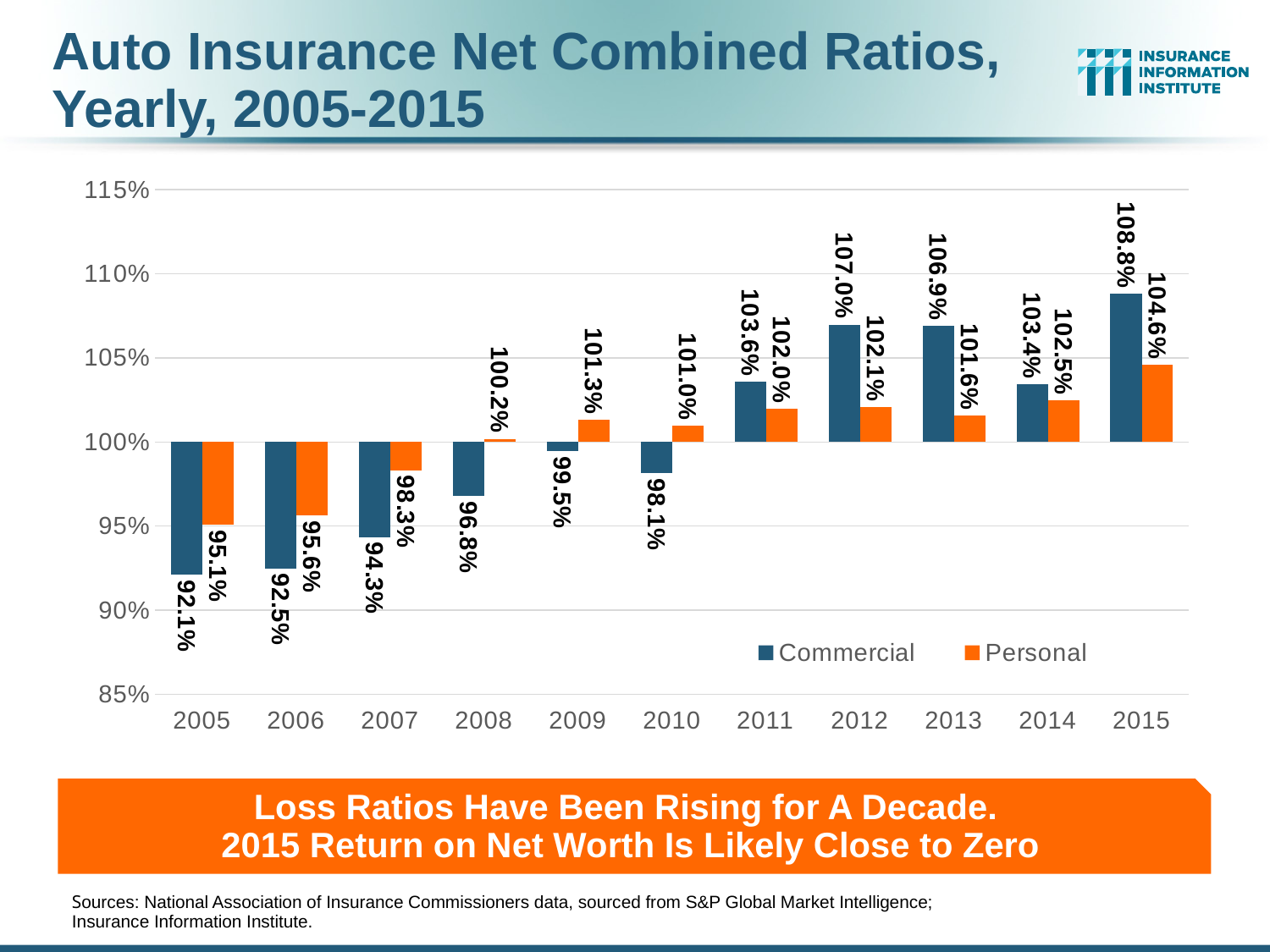
What is the Commercial net combined ratio for 2010? 98.1% What kind of chart is shown on the slide? Bar chart Which year has the highest Commercial net combined ratio? 2015 How many series does the legend list? 2 How many years are shown on the x axis? 11 Does the Personal net combined ratio generally rise or fall from 2005 to 2015? Rise What is the Commercial net combined ratio for 2015? 108.8% Which year has the lowest Personal net combined ratio? 2005 Which is larger in 2012, the Commercial ratio or the Personal ratio? Commercial What is the Personal net combined ratio for 2009? 101.3% What is the difference between the Commercial and Personal ratios in 2015? 4.2% Which is larger in 2008, the Commercial ratio or the Personal ratio? Personal